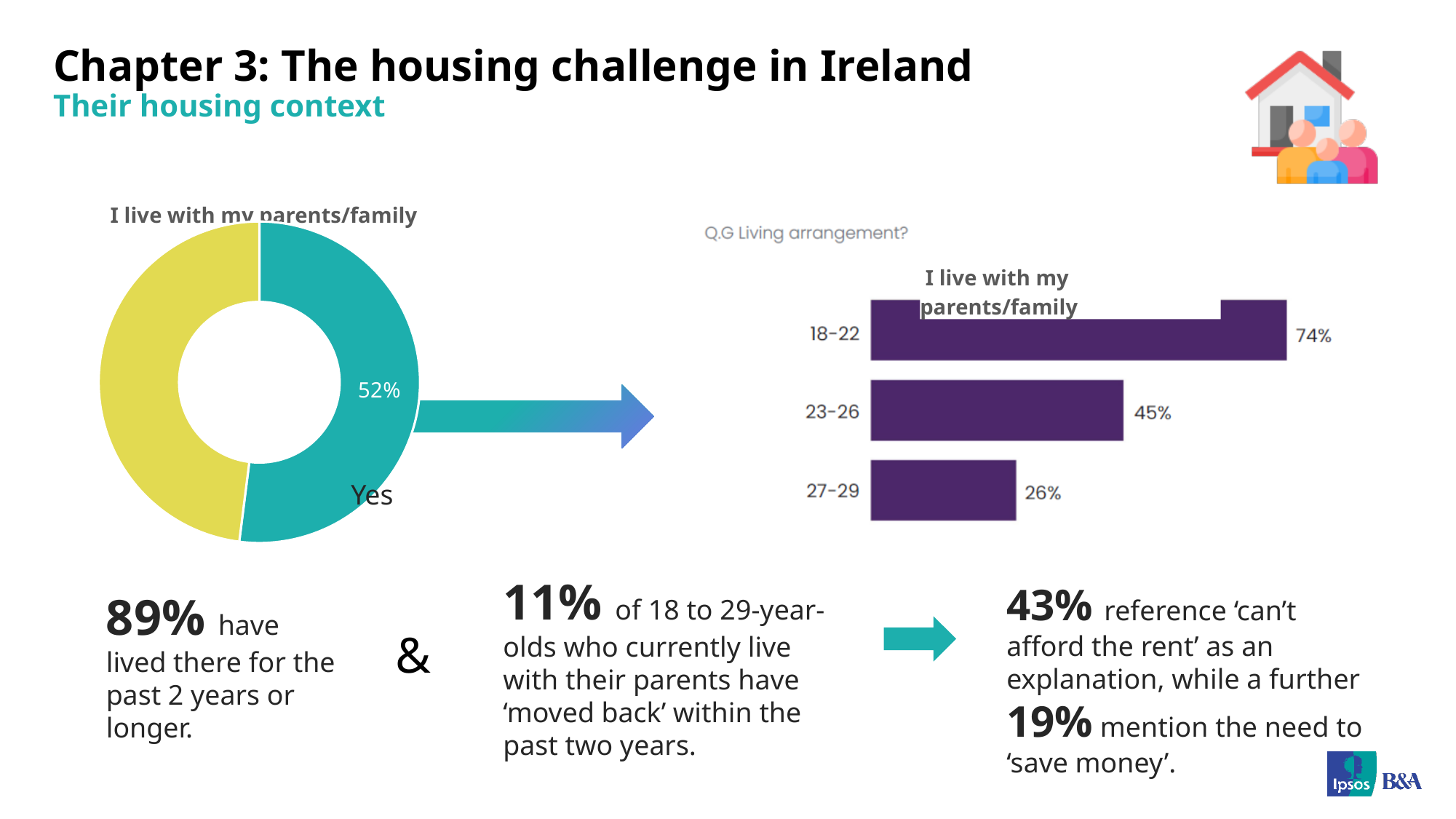
How many age groups are shown in the bar chart on the right? 3 In the bar chart on the right, what is the value for the 23-26 age group? 45% In the bar chart on the right, what is the difference between the values for the 18-22 and 27-29 age groups? 48 percentage points In the bar chart on the right, what is the value for the 18-22 age group? 74% What kind of chart is the chart on the left of the slide? Donut (pie) chart What kind of chart is the chart on the right of the slide showing age groups? Bar chart In the bar chart on the right, do the values rise or fall as the age groups get older? Fall In the bar chart on the right, which is larger: the value for 23-26 or the value for 27-29? 23-26 In the bar chart on the right, what is the value for the 27-29 age group? 26% In the donut chart on the left, what percentage is shown for the 'Yes' slice? 52% In the bar chart on the right, which age group has the lowest value? 27-29 In the bar chart on the right, which age group has the highest value? 18-22